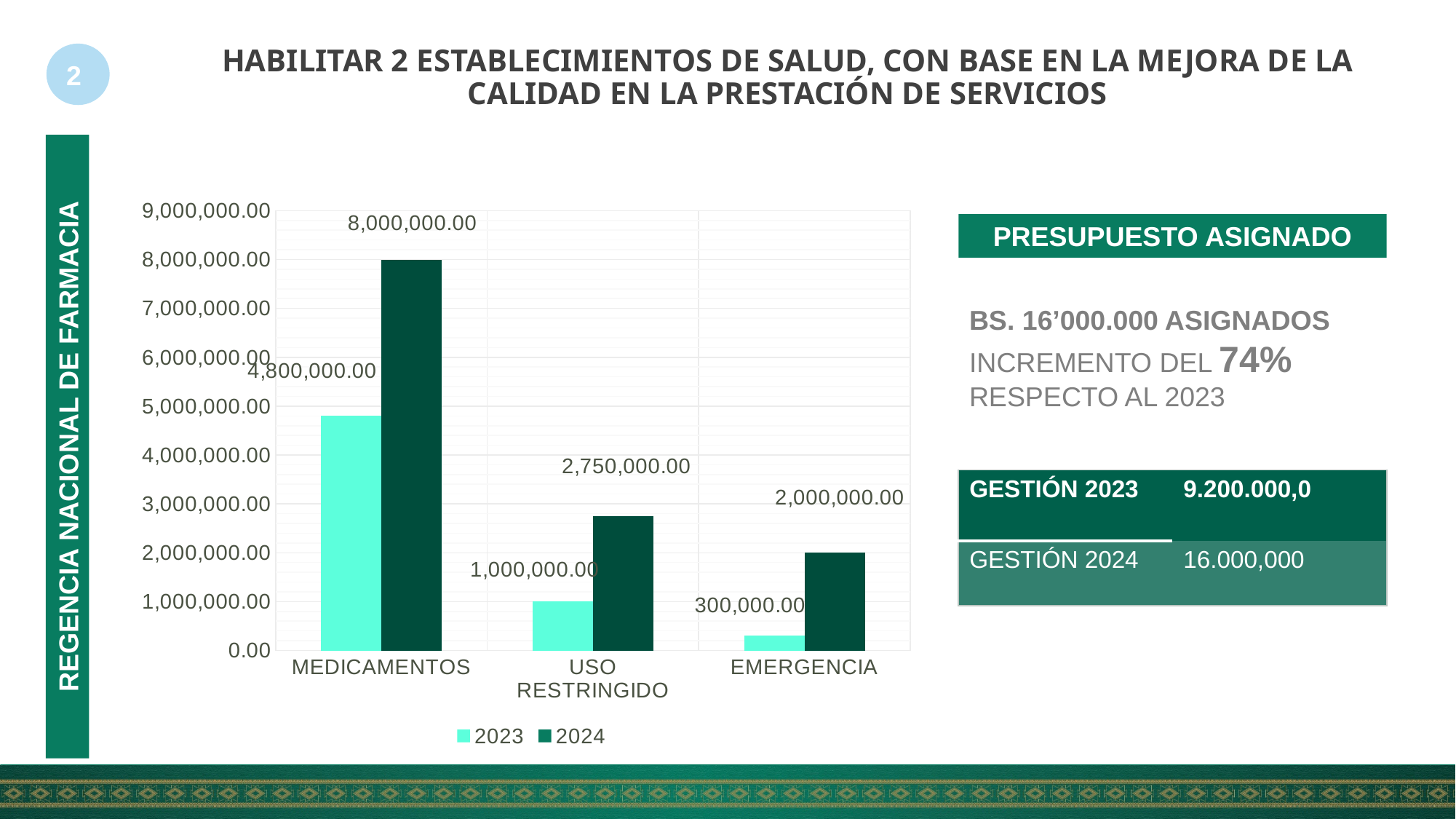
What is the value for USO RESTRINGIDO in the 2024 series? 2,750,000.00 Which is larger: the 2024 value for USO RESTRINGIDO or the 2024 value for EMERGENCIA? USO RESTRINGIDO What is the difference between the 2024 and 2023 values for EMERGENCIA? 1,700,000.00 What kind of chart is shown on the slide? Bar chart What is the value for MEDICAMENTOS in the 2024 series? 8,000,000.00 Which category has the highest value in the 2024 series? MEDICAMENTOS How many series does the chart legend list? 2 How many categories are shown on the x axis of the chart? 3 What is the value for EMERGENCIA in the 2023 series? 300,000.00 Which category has the lowest value in the 2023 series? EMERGENCIA What is the value for MEDICAMENTOS in the 2023 series? 4,800,000.00 What is the difference between the 2024 and 2023 values for MEDICAMENTOS? 3,200,000.00